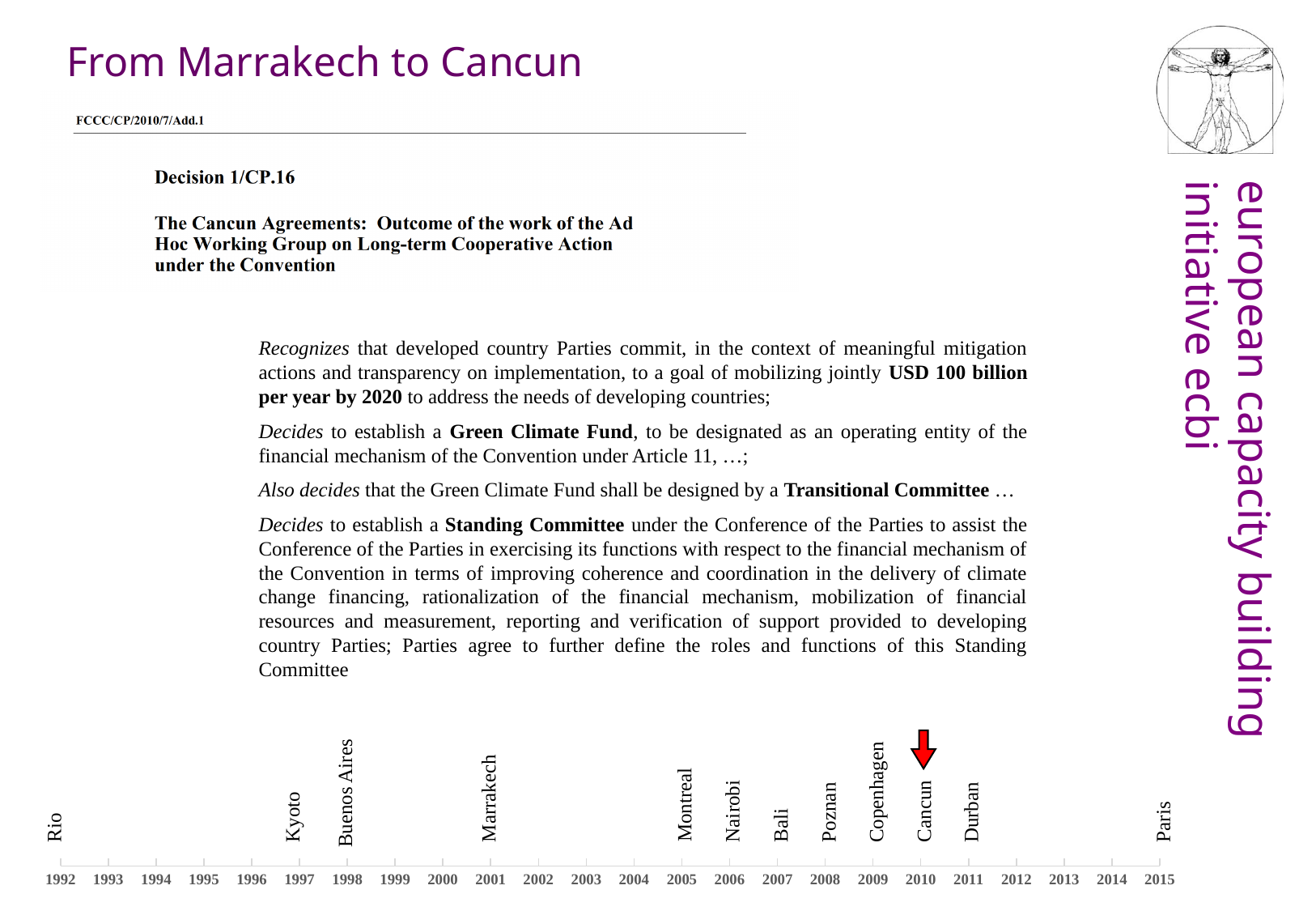
On the timeline at the bottom of the slide, which city label appears at 2015? Paris On the timeline at the bottom of the slide, which comes later, Bali or Durban? Durban On the timeline at the bottom of the slide, which city label appears at 1992? Rio On the timeline at the bottom of the slide, what is the earliest year shown? 1992 On the timeline at the bottom of the slide, how many year ticks are shown? 24 On the timeline at the bottom of the slide, which city label appears at 2010? Cancun On the timeline at the bottom of the slide, which city does the red arrow point to? Cancun On the timeline at the bottom of the slide, which year is labelled Kyoto? 1997 On the timeline at the bottom of the slide, which year is labelled Copenhagen? 2009 On the timeline at the bottom of the slide, how many city labels are shown? 12 On the timeline at the bottom of the slide, which year is labelled Marrakech? 2001 On the timeline at the bottom of the slide, what is the latest year shown? 2015